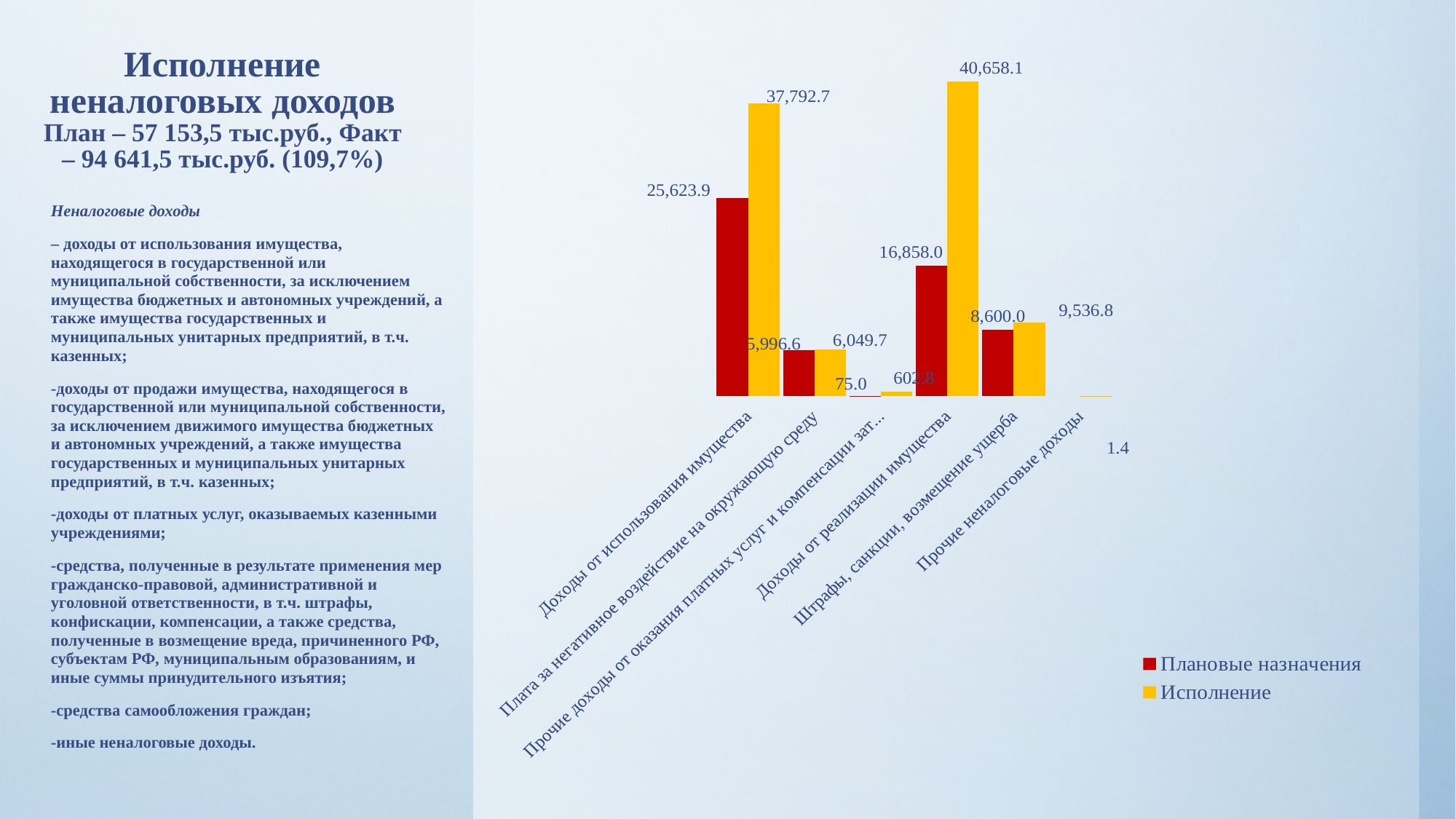
How many categories are shown on the x axis of the chart? 6 What is the Плановые назначения value for Плата за негативное воздействие на окружающую среду? 5,996.6 Which is larger for Штрафы, санкции, возмещение ущерба: Плановые назначения or Исполнение? Исполнение What is the Исполнение value for Доходы от использования имущества? 37,792.7 What is the Исполнение value for Штрафы, санкции, возмещение ущерба? 9,536.8 Which colour represents the Исполнение series in the chart? yellow How many series does the chart legend list? 2 Which category has the highest Исполнение value? Доходы от реализации имущества What type of chart is shown on the slide? bar chart What is the Плановые назначения value for Доходы от реализации имущества? 16,858.0 Which category has the highest Плановые назначения value? Доходы от использования имущества What is the difference between the Исполнение and Плановые назначения values for Доходы от реализации имущества? 23,800.1